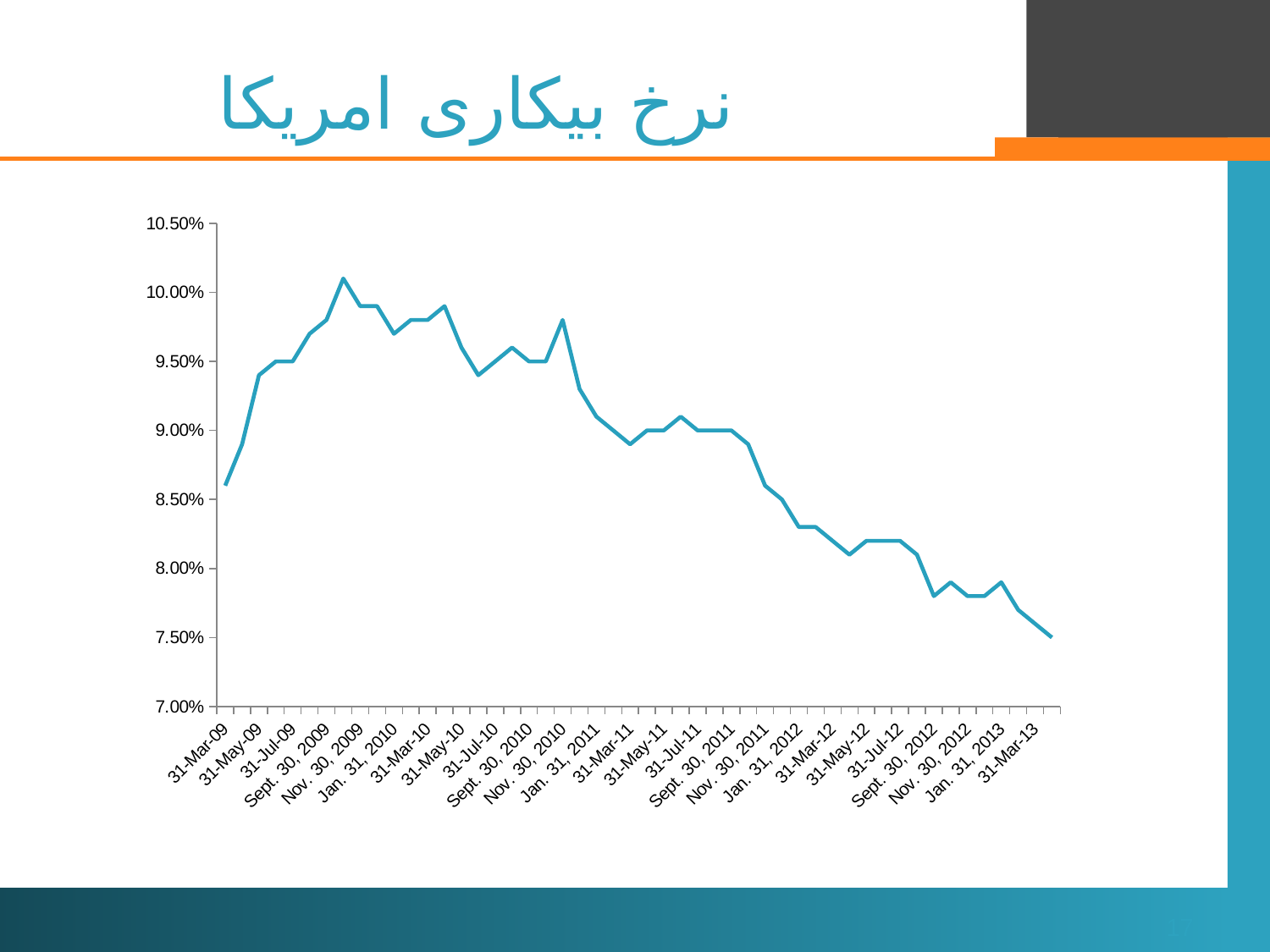
Is the value for Nov. 30, 2011 greater or less than 9.00%? less Is the value for 31-May-12 greater or less than 8.50%? less Is the value for 31-Mar-13 greater or less than 8.00%? less Which labelled date on the x axis has the lowest value on the line? 31-Mar-13 How many lines (data series) are plotted on the chart? 1 Between Nov. 30, 2011 and 31-Mar-13, does the line generally rise or fall? fall Between 31-Mar-09 and Sept. 30, 2009, does the line rise or fall? rise Which is larger, the value for 31-Mar-09 or the value for 31-Mar-13? 31-Mar-09 What kind of chart is shown on the slide? line chart Which is larger, the value for Jan. 31, 2010 or the value for Jan. 31, 2013? Jan. 31, 2010 What is the highest tick value shown on the y axis? 10.50%